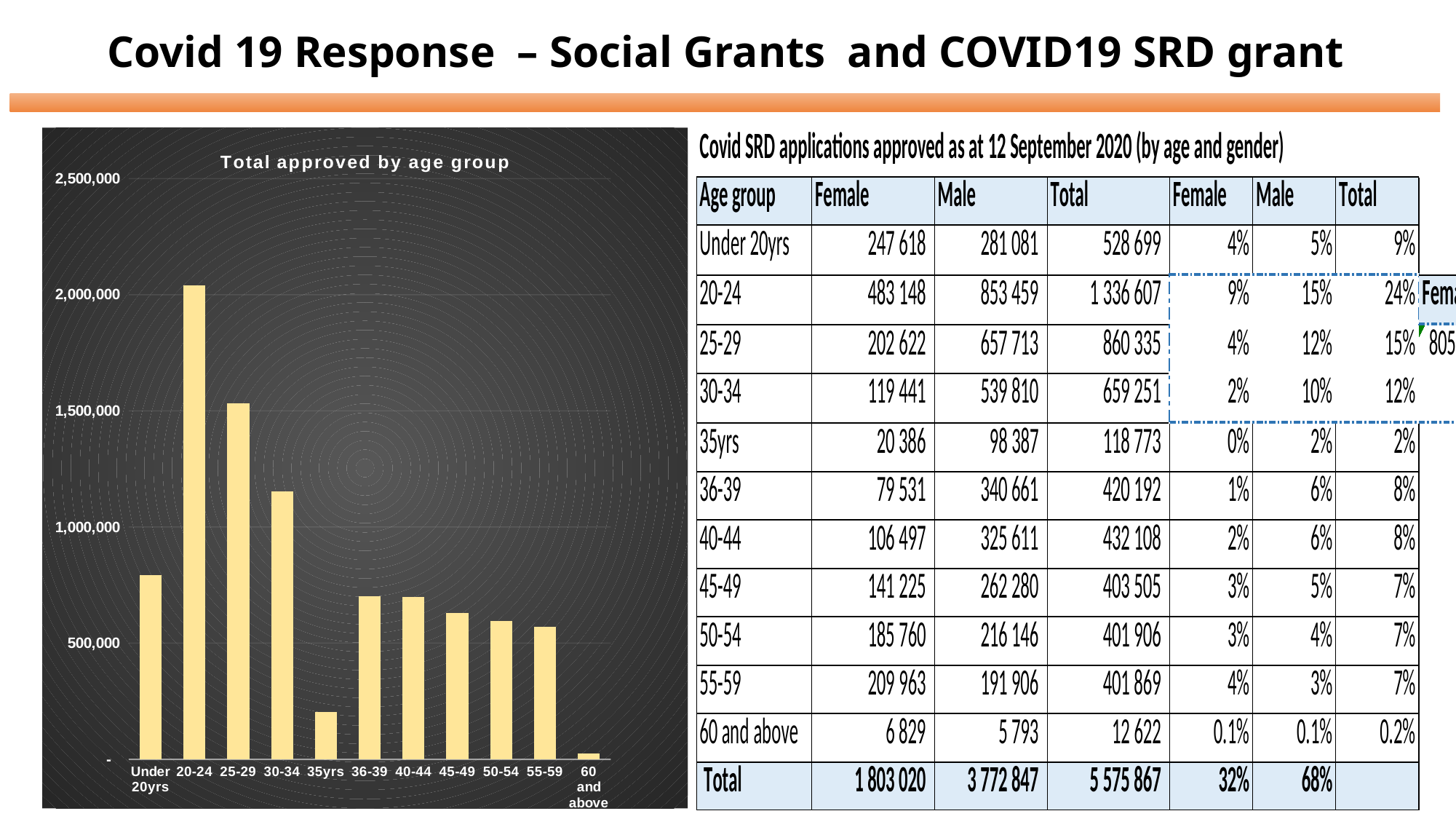
In the 'Total approved by age group' chart, is the value for 20-24 greater or less than 1,500,000? greater What kind of chart is shown on the left of the slide? bar chart In the 'Total approved by age group' chart, is the value for 35yrs greater or less than 500,000? less In the 'Total approved by age group' chart, do the values rise or fall from 20-24 through 30-34? fall What is the title of the chart on the left of the slide? Total approved by age group In the 'Total approved by age group' chart, which is larger, the bar for Under 20yrs or the bar for 36-39? Under 20yrs In the 'Total approved by age group' chart, which age group has the highest bar? 20-24 In the 'Total approved by age group' chart, is the value for 25-29 greater or less than 1,000,000? greater In the 'Total approved by age group' chart, which age group has the lowest bar? 60 and above How many age-group categories are plotted in the 'Total approved by age group' chart? 11 In the 'Total approved by age group' chart, which is larger, the bar for 25-29 or the bar for 30-34? 25-29